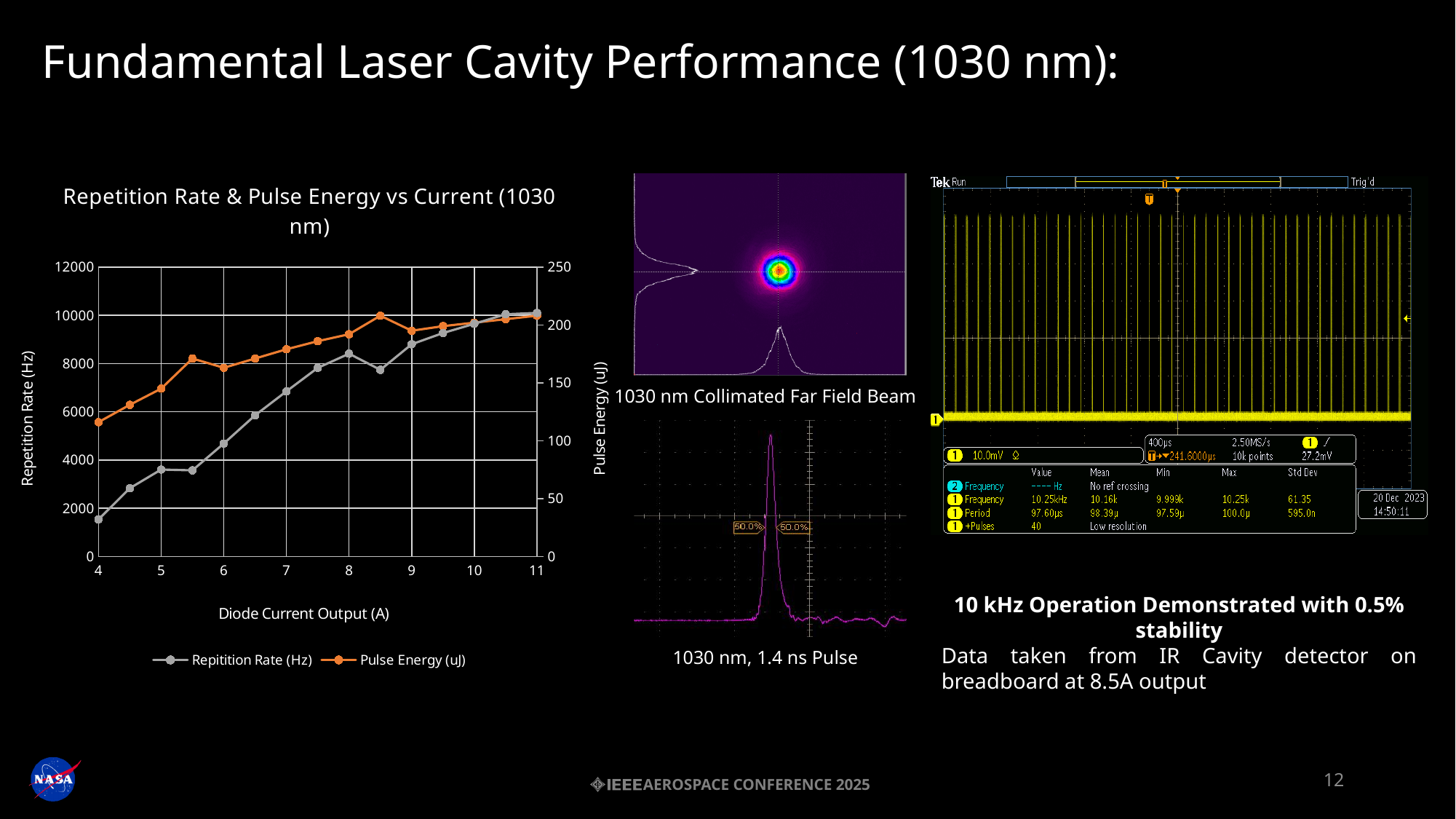
What is the x-axis label of the "Repetition Rate & Pulse Energy vs Current (1030 nm)" chart? Diode Current Output (A) In the "Repetition Rate & Pulse Energy vs Current (1030 nm)" chart, does the pulse energy generally rise or fall as diode current increases? rise What kind of chart is "Repetition Rate & Pulse Energy vs Current (1030 nm)"? line chart How many data points are plotted for the Repetition Rate series in the "Repetition Rate & Pulse Energy vs Current (1030 nm)" chart? 15 In the "Repetition Rate & Pulse Energy vs Current (1030 nm)" chart, is the repetition rate at 4 A greater or less than 2000 Hz? less In the "Repetition Rate & Pulse Energy vs Current (1030 nm)" chart, is the pulse energy at 4 A greater or less than 100 uJ? greater In the "Repetition Rate & Pulse Energy vs Current (1030 nm)" chart, is the repetition rate at 7 A greater or less than 8000 Hz? less In the "Repetition Rate & Pulse Energy vs Current (1030 nm)" chart, at which diode current is the repetition rate lowest? 4 A In the "Repetition Rate & Pulse Energy vs Current (1030 nm)" chart, is the repetition rate higher at 8 A or at 8.5 A? 8 A How many series does the legend of the "Repetition Rate & Pulse Energy vs Current (1030 nm)" chart list? 2 In the "Repetition Rate & Pulse Energy vs Current (1030 nm)" chart, which colour is used for the Pulse Energy (uJ) series? orange